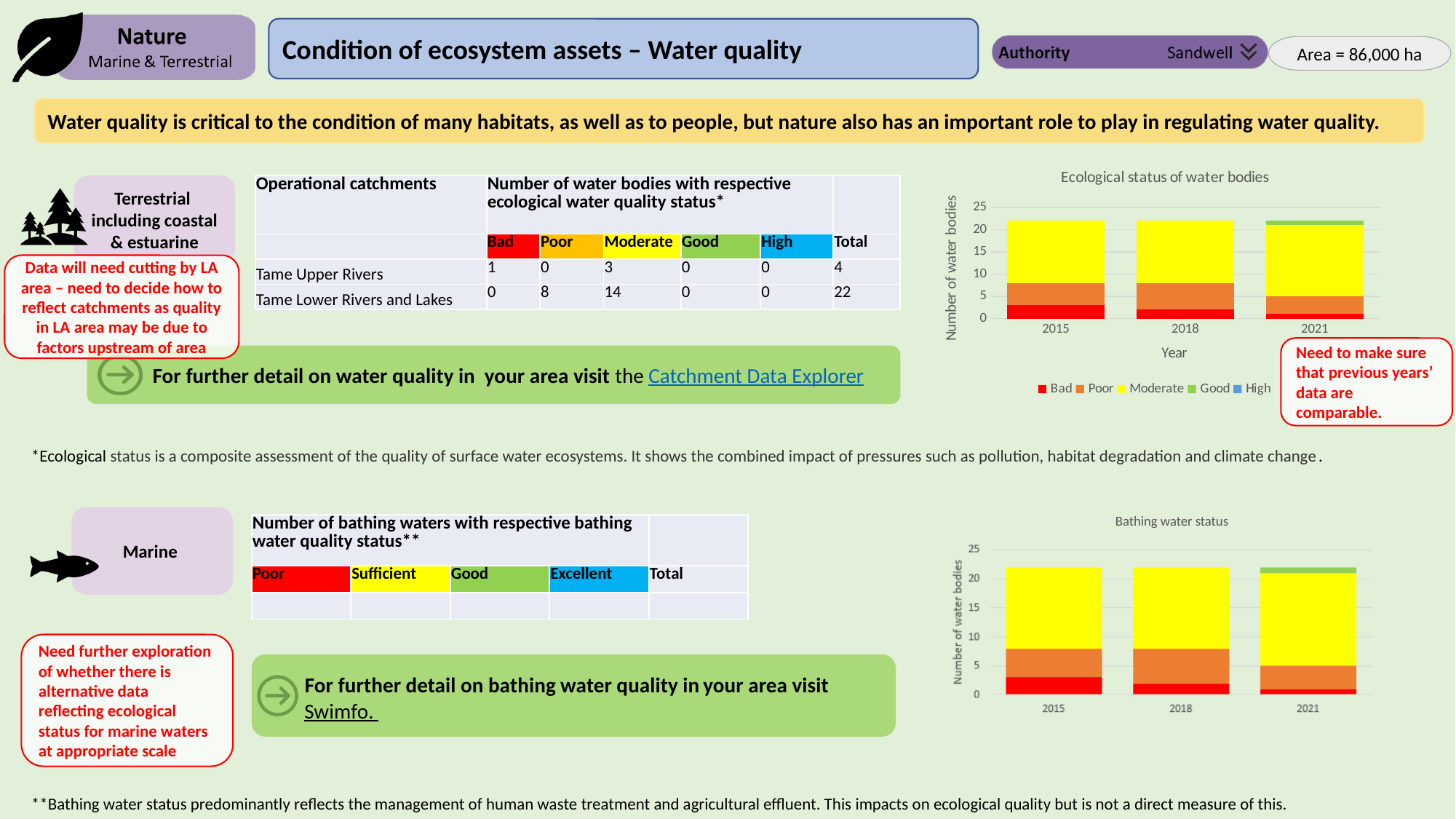
What kind of chart is the 'Ecological status of water bodies' chart? Stacked bar chart In the 'Ecological status of water bodies' chart, is the total height of the 2015 bar greater or less than 20? greater In the 'Ecological status of water bodies' chart, which year has the largest Bad segment? 2015 In the 'Ecological status of water bodies' chart, is the Moderate segment for 2021 greater or less than 10? greater In the 'Ecological status of water bodies' chart, is the Bad segment for 2015 greater or less than 5? less How many series does the legend of the 'Ecological status of water bodies' chart list? 5 In the 'Bathing water status' chart, is the Bad (red) segment for 2015 larger or smaller than for 2021? larger How many years are shown on the x axis of the 'Ecological status of water bodies' chart? 3 What is the y-axis label of the 'Bathing water status' chart? Number of water bodies In the 'Ecological status of water bodies' chart, does the Bad segment rise or fall from 2015 to 2021? fall In the 'Ecological status of water bodies' chart, which year is the only one with a visible Good segment? 2021 In the 'Ecological status of water bodies' chart, which year has the smallest Bad segment? 2021